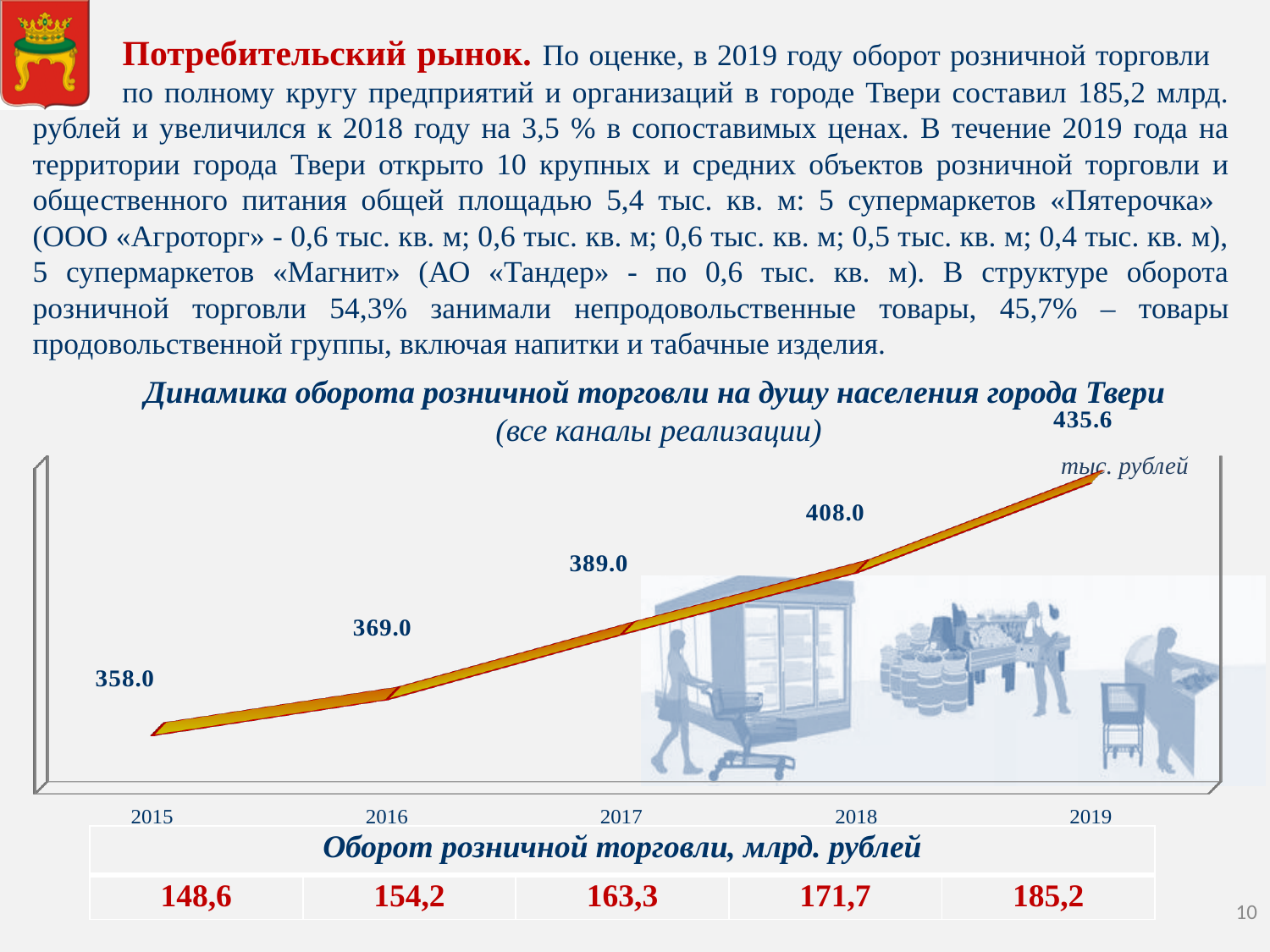
What kind of chart is used to show the dynamics of retail turnover per capita in Tver? line chart What is the difference between the 2016 and 2015 values on the chart of retail turnover per capita in Tver? 11.0 Do the values on the chart of retail turnover per capita in Tver rise or fall from 2015 to 2019? rise How many years are plotted on the chart of retail turnover per capita in Tver? 5 What is the value for 2015 on the chart of retail turnover per capita in Tver? 358.0 Which year has the highest value on the chart of retail turnover per capita in Tver? 2019 Which year has the lowest value on the chart of retail turnover per capita in Tver? 2015 By how much does the 2019 value exceed the 2018 value on the chart of retail turnover per capita in Tver? 27.6 What is the value for 2019 on the chart of retail turnover per capita in Tver? 435.6 What is the value for 2017 on the chart of retail turnover per capita in Tver? 389.0 On the chart of retail turnover per capita in Tver, which year has the larger value, 2017 or 2018? 2018 In what units are the values on the chart of retail turnover per capita in Tver expressed? тыс. рублей